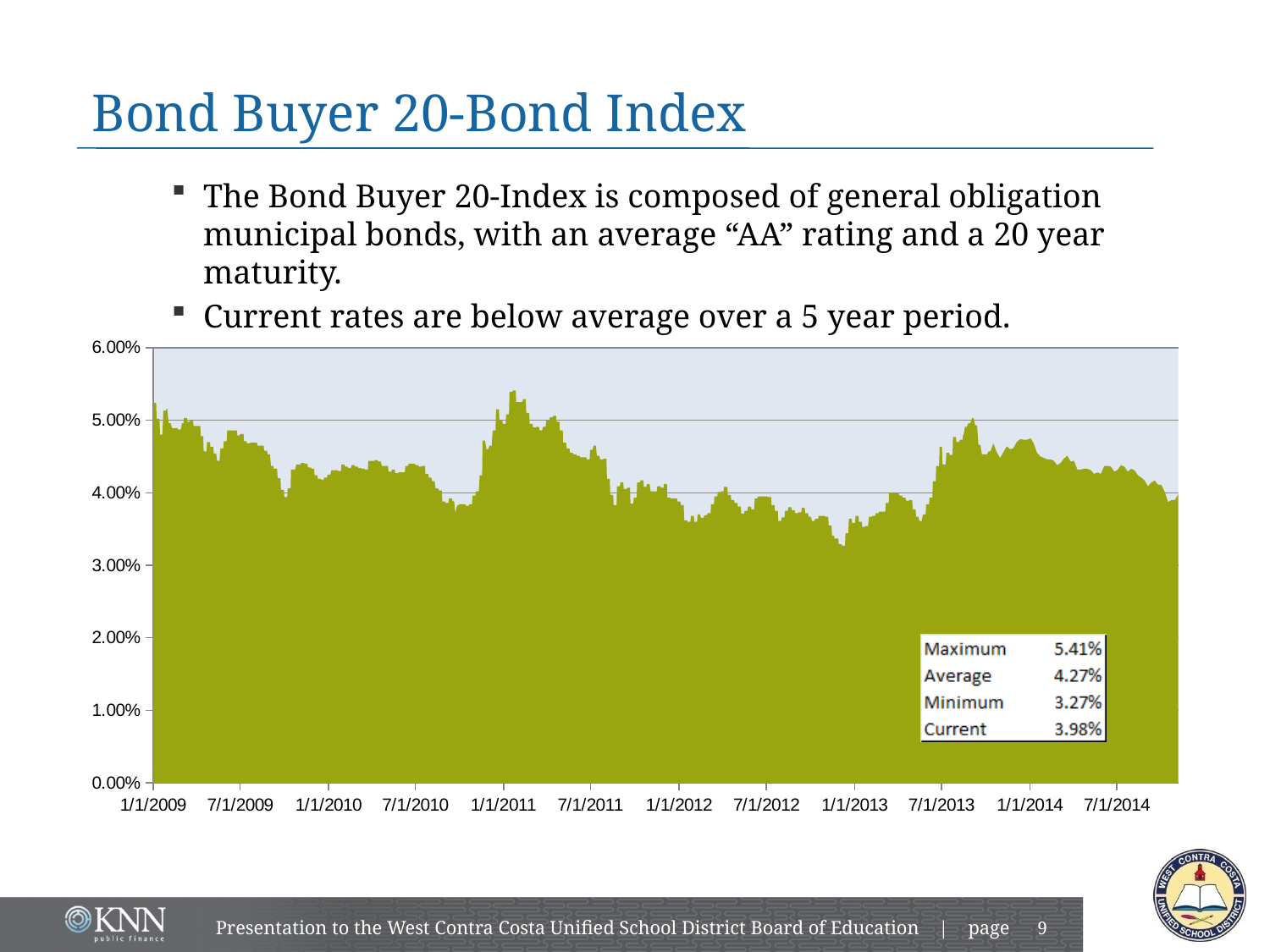
What is the Maximum value listed in the chart's summary box? 5.41% What is the difference between the Maximum and Minimum values shown in the summary box? 2.14% What kind of chart is shown on the slide? area chart What is the difference between the Average and Current values shown in the summary box? 0.29% Which is larger, the Current value or the Average value? Average What is the Average value listed in the chart's summary box? 4.27% What is the Current value listed in the chart's summary box? 3.98% How many date labels are shown on the x axis? 12 Do the values rise or fall between 1/1/2014 and 7/1/2014? fall What is the Minimum value listed in the chart's summary box? 3.27% Is the value at 1/1/2013 greater or less than 4.00%? less Is the value at 1/1/2011 greater or less than 4.00%? greater